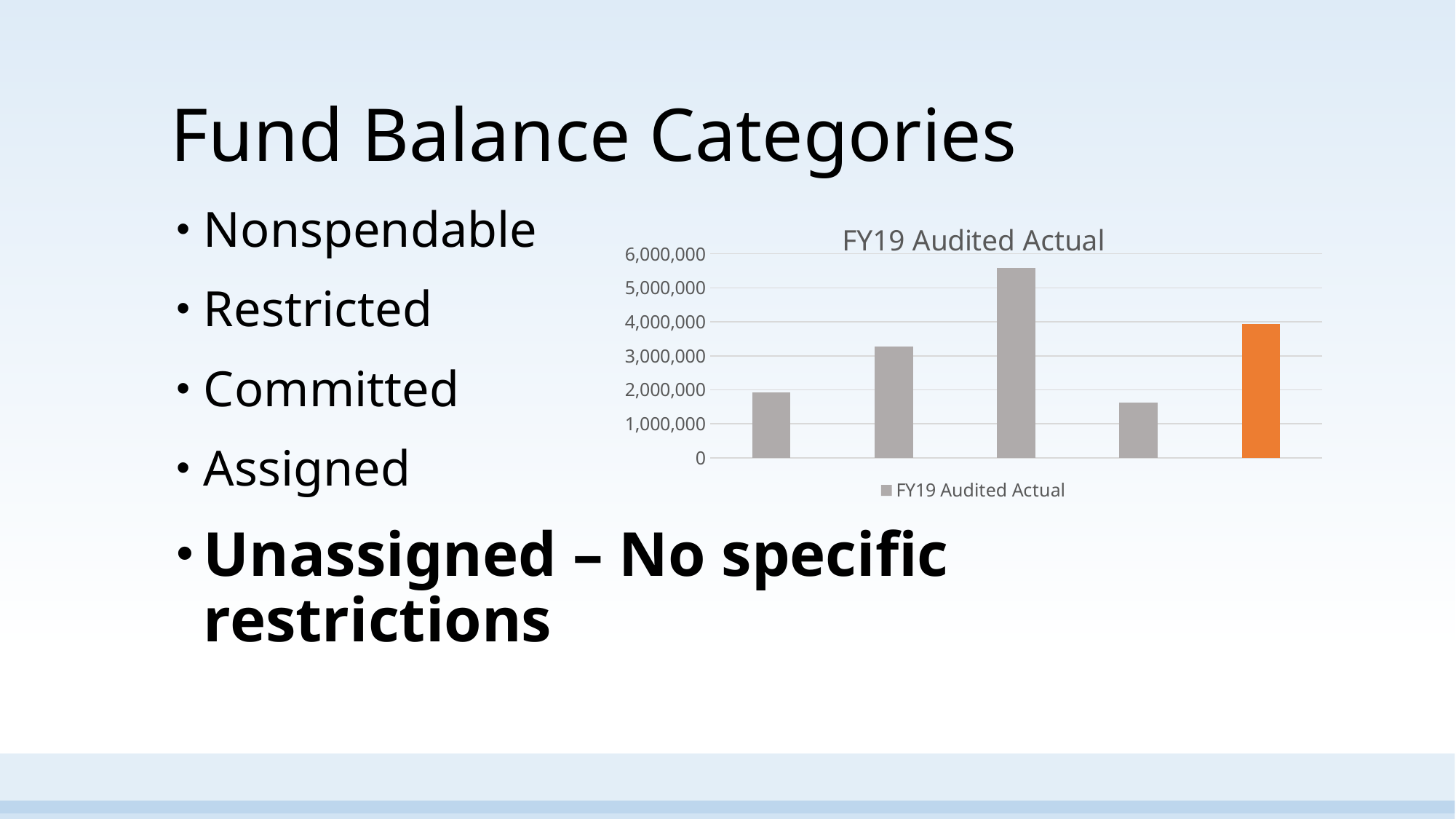
Which bar is the shortest in the chart, counting from the left? the fourth bar What colour is the rightmost bar in the chart? orange What kind of chart is shown on the slide? bar chart Is the value of the third bar from the left greater or less than 5,000,000? greater How many series does the chart legend list? 1 Which bar is the tallest in the chart, counting from the left? the third bar How many bars are plotted in the chart? 5 Is the value of the fourth bar from the left greater or less than 2,000,000? less What is the title of the chart? FY19 Audited Actual Is the value of the orange bar greater or less than 3,000,000? greater Which is larger, the second bar from the left or the orange bar on the right? the orange bar